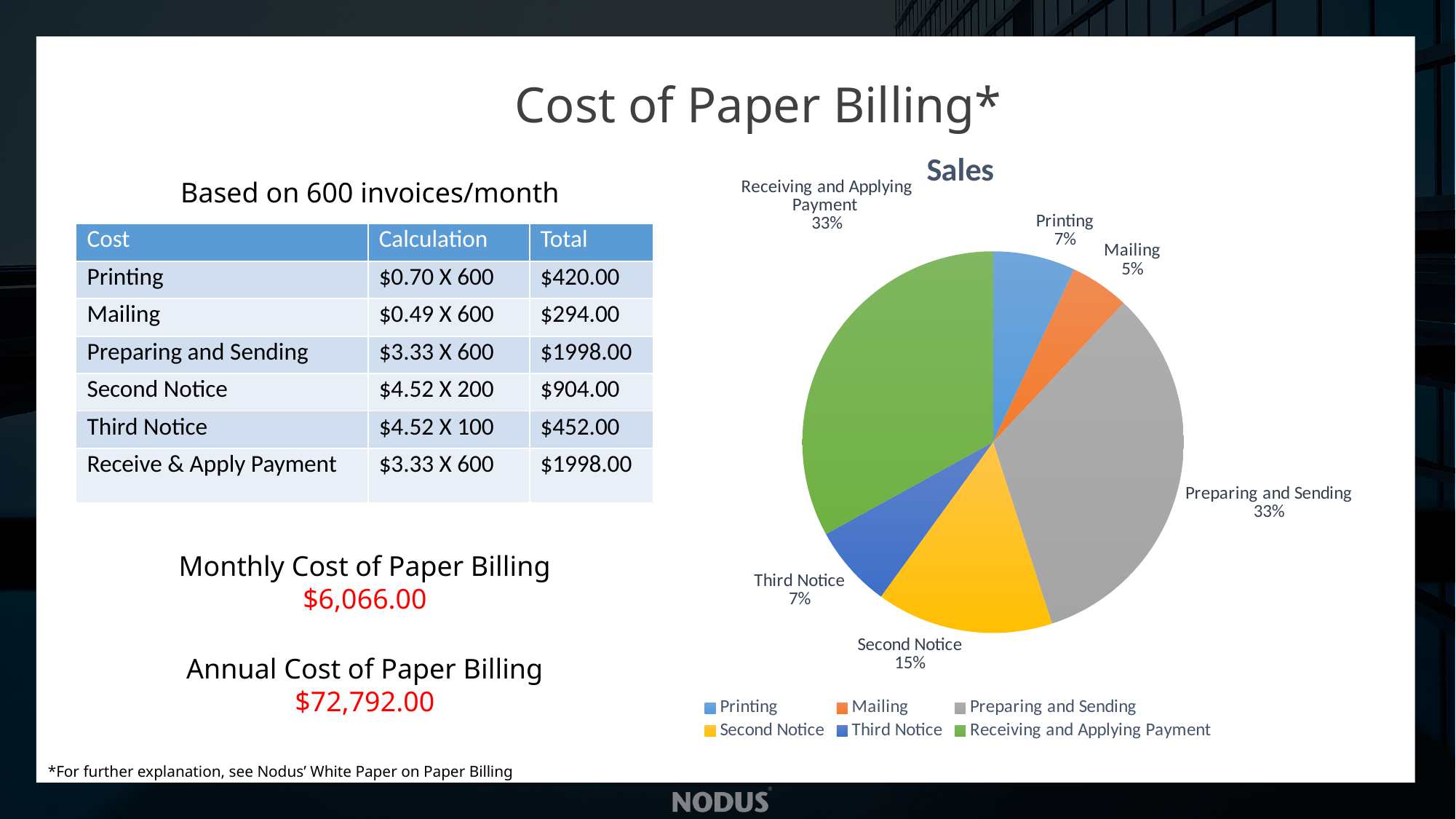
What is the title of the chart? Sales What is the difference in percentage points between Preparing and Sending and Second Notice? 18 What percentage is shown for Third Notice? 7% Which is larger, the Second Notice slice or the Printing slice? Second Notice What percentage is shown for Second Notice? 15% Which is larger, the Receiving and Applying Payment slice or the Third Notice slice? Receiving and Applying Payment Which slice of the pie is the smallest? Mailing What share of the pie does Mailing represent? 5% What is the difference in percentage points between Printing and Mailing? 2 How many slices does the pie chart have? 6 What type of chart is shown on the slide? Pie chart What percentage is shown for Preparing and Sending? 33%